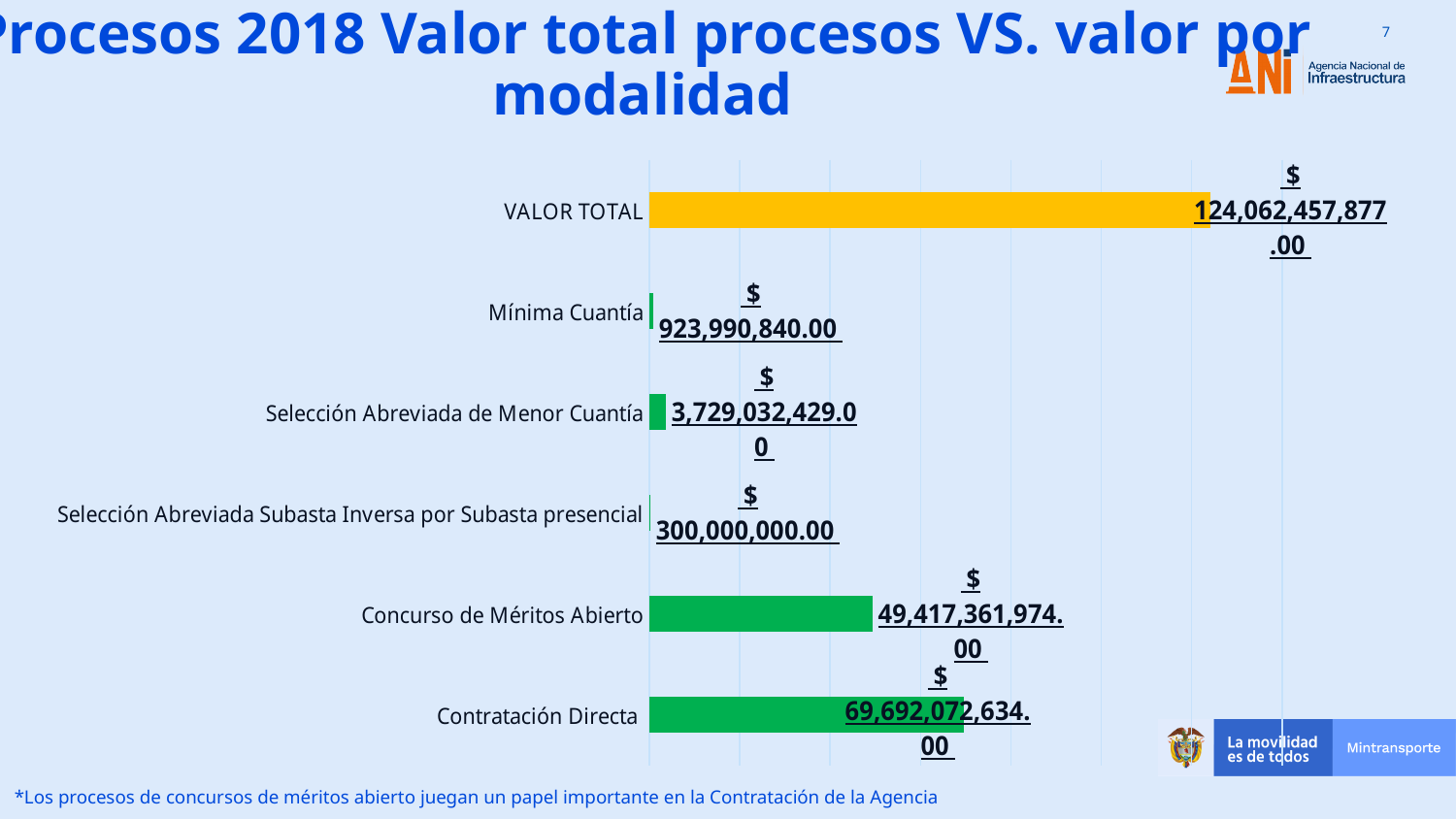
What is the difference between the values for Contratación Directa and Concurso de Méritos Abierto? $20,274,710,660.00 Excluding VALOR TOTAL, which modality has the highest value? Contratación Directa Which is larger, the value for Selección Abreviada de Menor Cuantía or the value for Mínima Cuantía? Selección Abreviada de Menor Cuantía What is the value shown for VALOR TOTAL? $124,062,457,877.00 What is the value shown for Concurso de Méritos Abierto? $49,417,361,974.00 What is the value shown for Selección Abreviada Subasta Inversa por Subasta presencial? $300,000,000.00 What is the value shown for Contratación Directa? $69,692,072,634.00 What is the value shown for Mínima Cuantía? $923,990,840.00 What colour is the VALOR TOTAL bar? Yellow What kind of chart is shown on the slide? Bar chart Which category has the lowest value? Selección Abreviada Subasta Inversa por Subasta presencial How many categories are plotted in the chart? 6